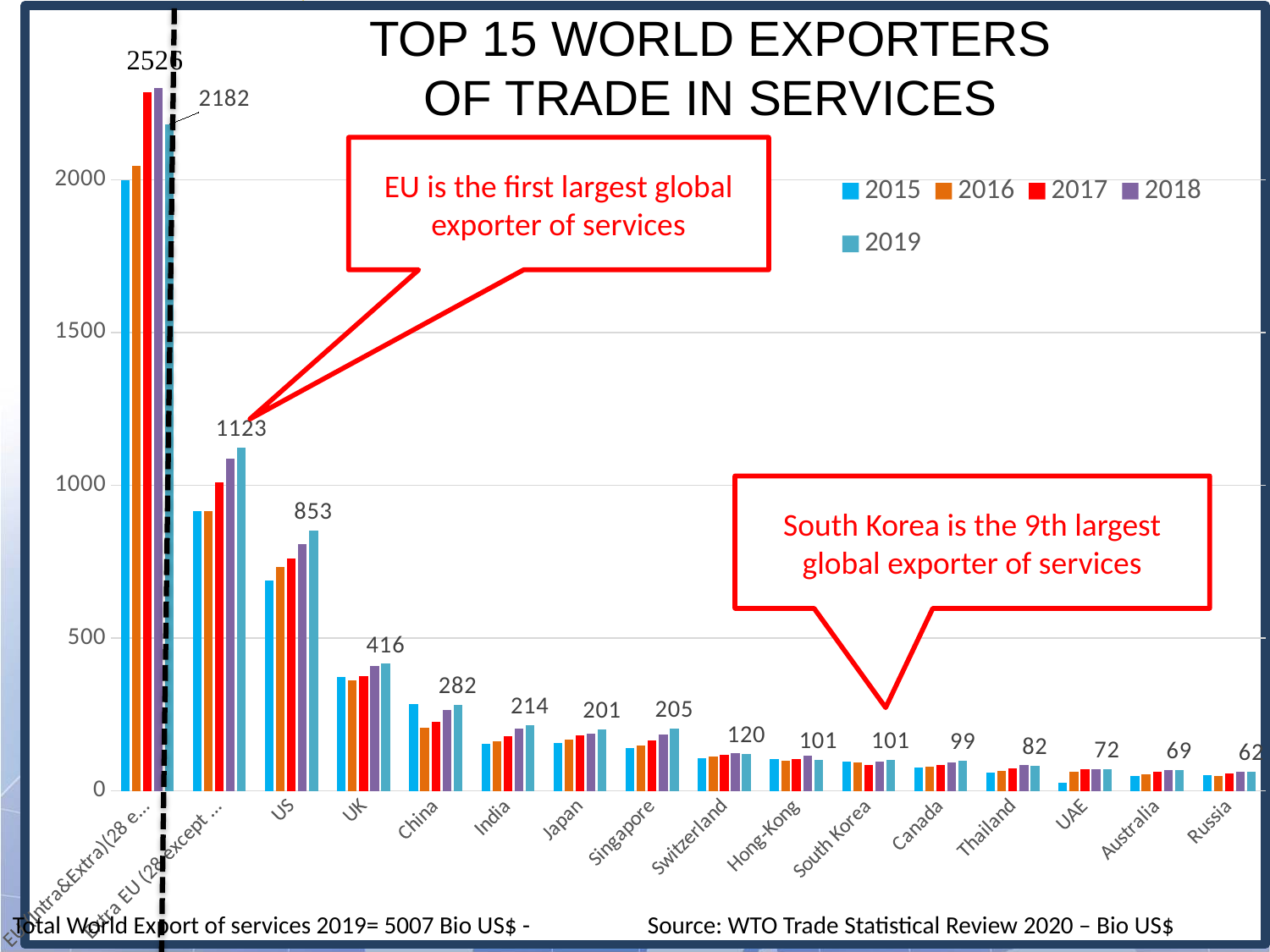
What is the labelled value for South Korea? 101 Is the 2015 value for the US greater or less than 500? greater Which has the larger labelled value, Singapore or Japan? Singapore Which category has the lowest labelled value? Russia Do the bars for the US rise or fall from 2015 to 2019? rise What is the labelled value for the US? 853 What is the title of the chart? TOP 15 WORLD EXPORTERS OF TRADE IN SERVICES How many exporter categories are shown on the x axis? 16 What is the difference between the labelled values for China and India? 68 What is the labelled value for the UK? 416 How many series does the legend list? 5 What kind of chart is shown on the slide? bar chart